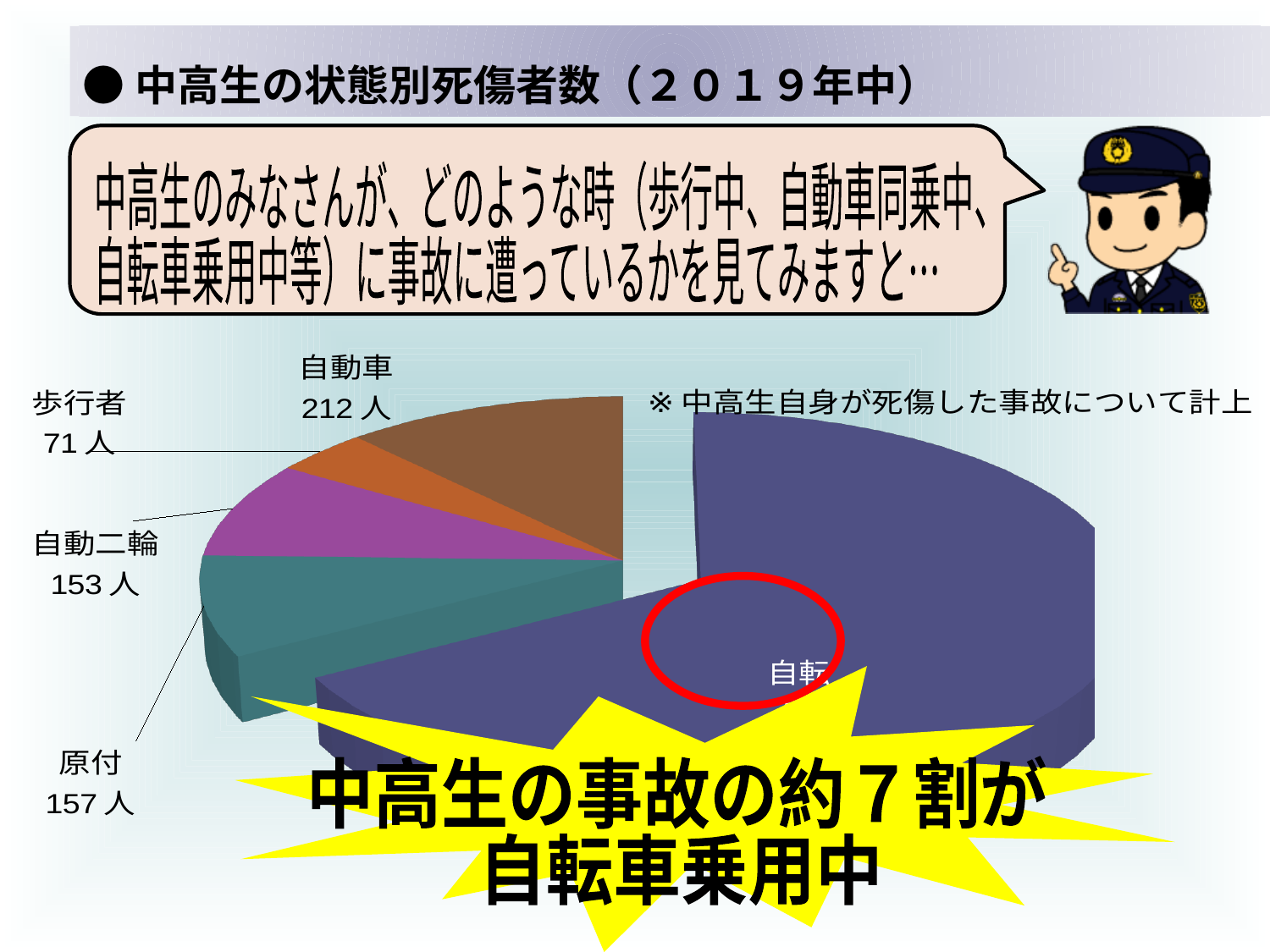
What is the difference between the values for 自動車 and 歩行者? 141人 How many categories does the pie chart have? 5 Which category has the largest slice in the pie chart? 自転車 What is the difference between the values for 原付 and 自動二輪? 4人 What is the title of the slide above the chart? 中高生の状態別死傷者数（２０１９年中） What kind of chart is shown on the slide? pie chart What is the value for 原付 in the pie chart? 157人 Which category has the smallest slice in the pie chart? 歩行者 What is the value for 自動車 in the pie chart? 212人 What is the value for 歩行者 in the pie chart? 71人 What is the value for 自動二輪 in the pie chart? 153人 Which is larger, the value for 自動車 or the value for 自動二輪? 自動車